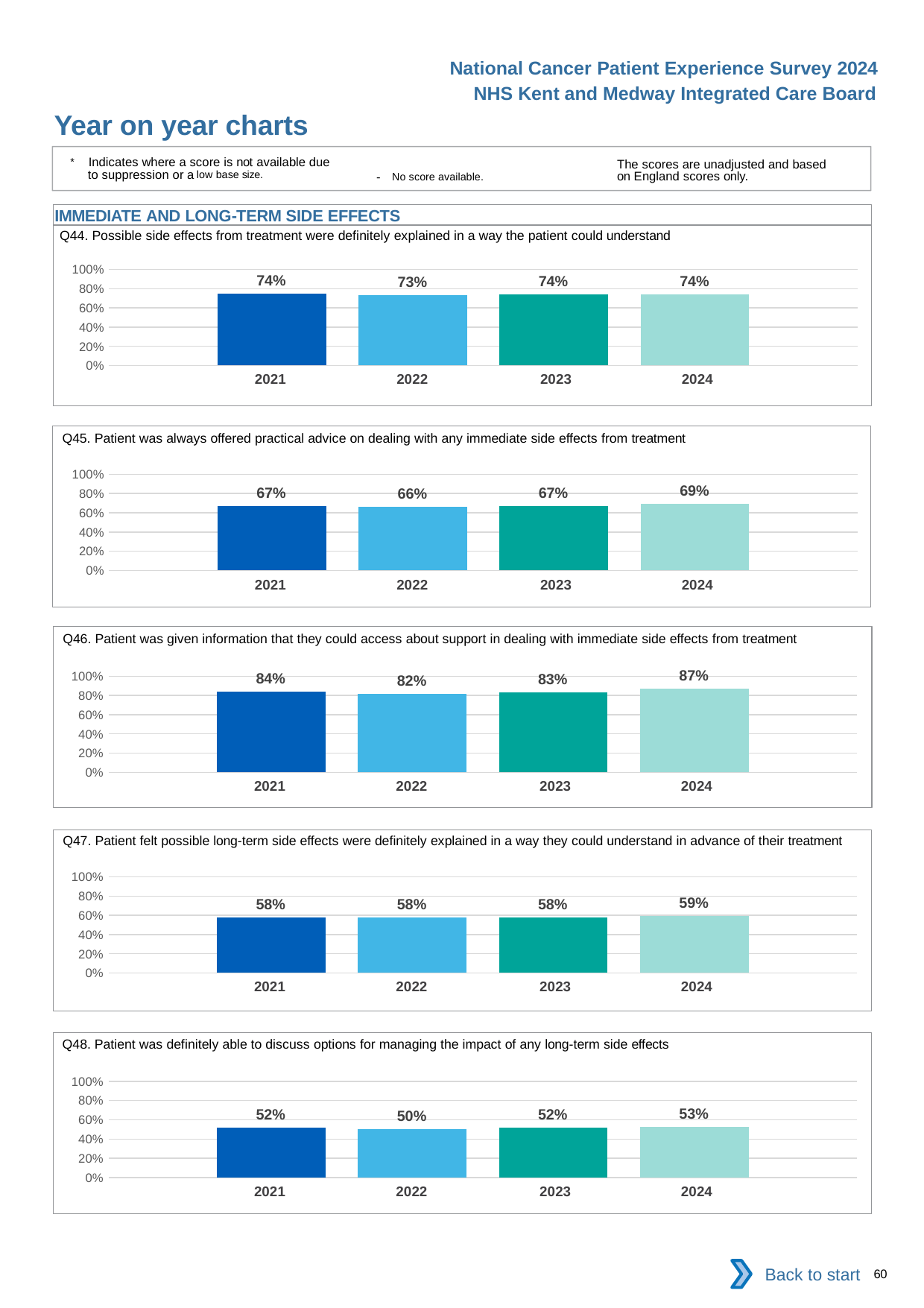
In the Q48 chart, which is larger, the value for 2022 or the value for 2024? 2024 In the Q46 chart, what is the difference between the 2024 and 2021 values? 3% In the Q47 chart, what is the value for 2024? 59% In the Q44 chart, what is the value for 2022? 73% In the Q45 chart, what is the difference between the 2024 and 2022 values? 3% In the Q46 chart, which year has the lowest value? 2022 In the Q48 chart, is the value for 2021 greater or less than 60%? less In the Q46 chart, what is the value for 2024? 87% In the Q48 chart, what is the value for 2022? 50% What kind of chart is the Q47 chart? bar chart How many years are shown in the Q44 chart? 4 In the Q45 chart, which year has the highest value? 2024